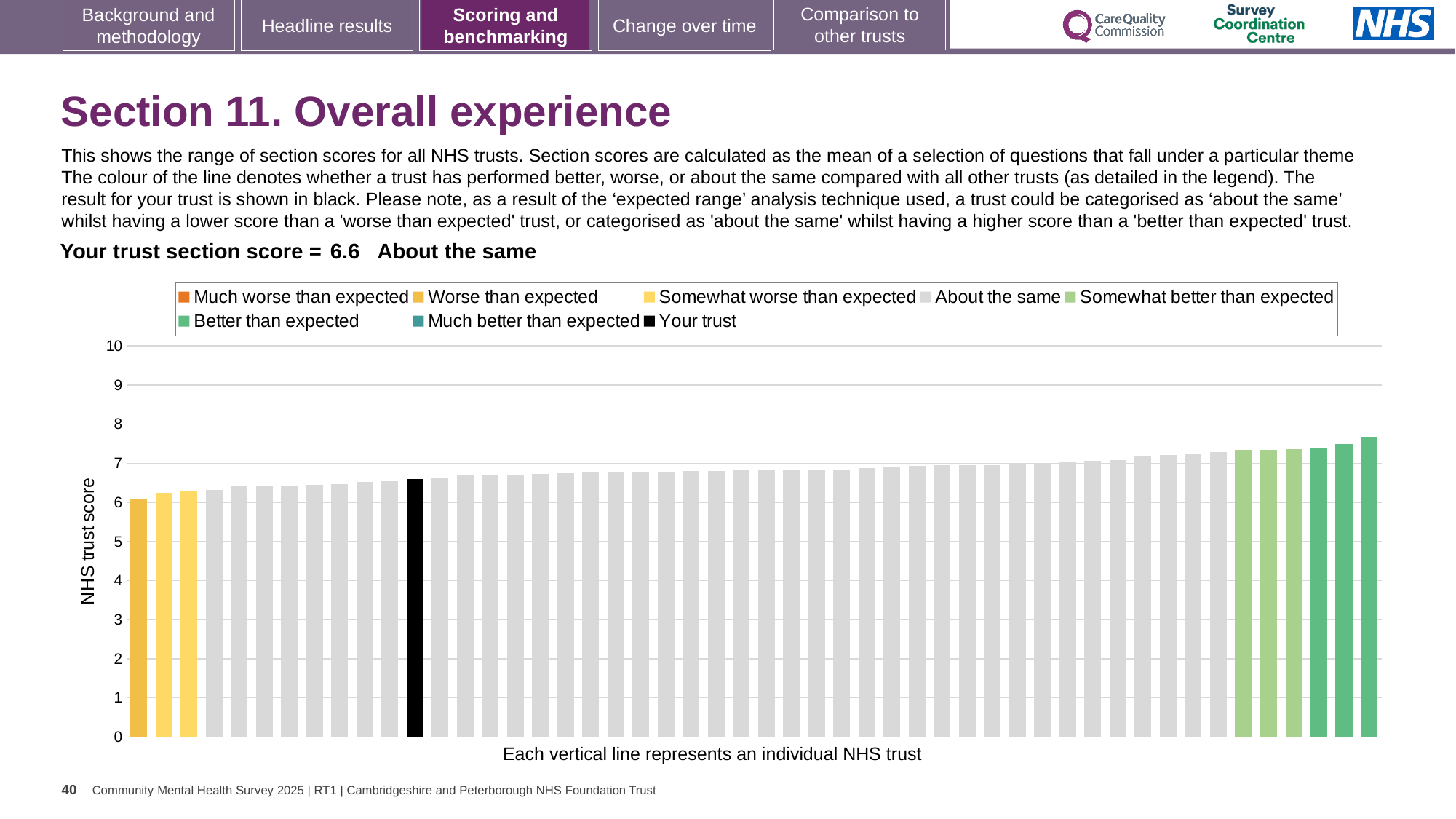
Is the value for the highest-scoring trust greater or less than 8? less What is the label on the vertical axis of the chart? NHS trust score What colour is the bar representing your trust? Black Do the trust scores rise or fall moving from left to right along the x axis? Rise How many entries does the chart legend list? 8 What kind of chart is shown on the slide? Bar chart Is the value for your trust greater or less than 6? greater Is the value for the lowest-scoring trust greater or less than 5? greater Which category is your trust's section score placed in? About the same What is the highest value shown on the vertical axis? 10 What is the section score for your trust shown on the slide? 6.6